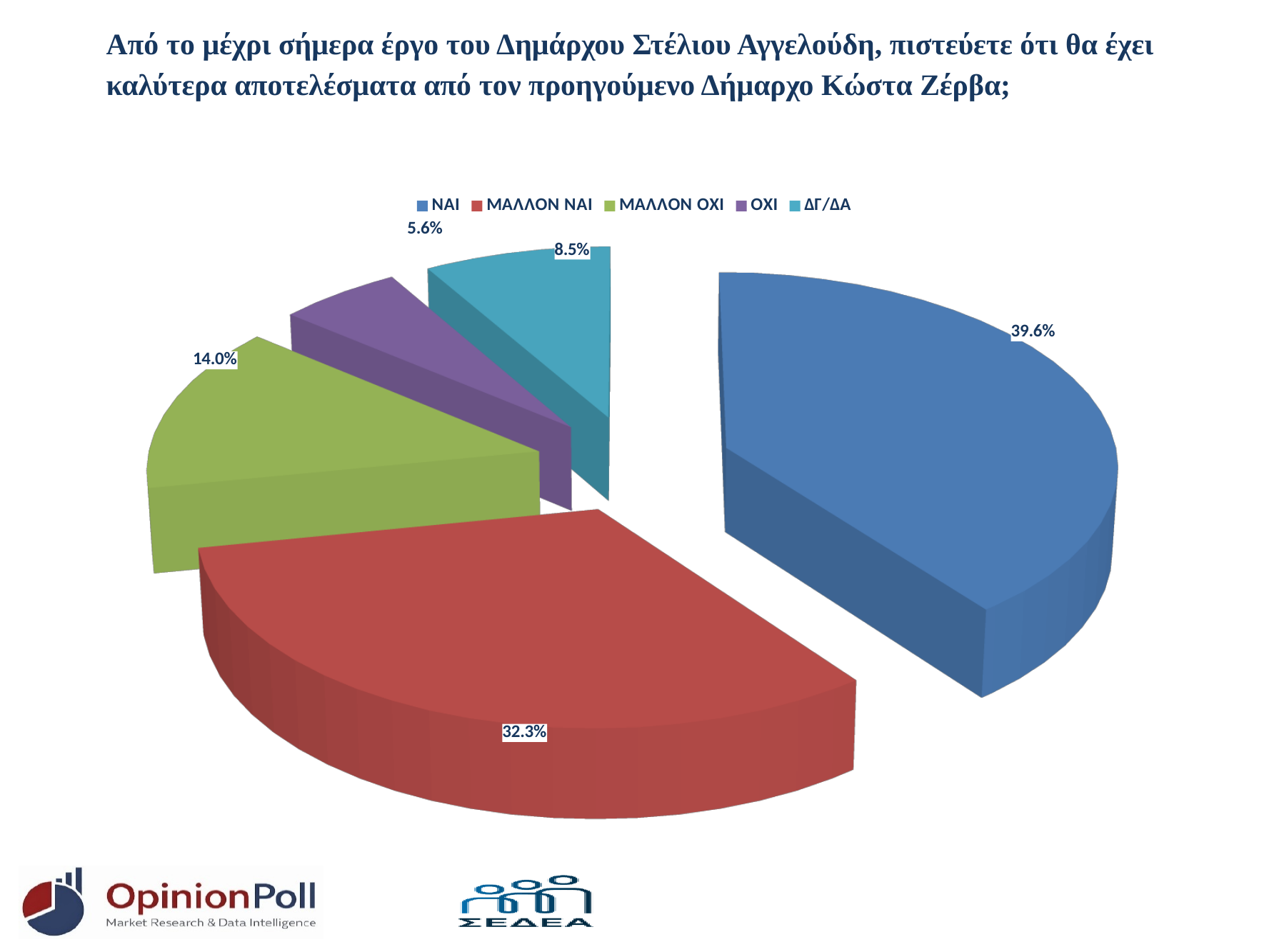
What percentage of respondents answered ΝΑΙ? 39.6% What percentage of respondents answered ΔΓ/ΔΑ? 8.5% Which is larger, the share for ΔΓ/ΔΑ or the share for ΟΧΙ? ΔΓ/ΔΑ How many categories does the legend list? 5 What percentage of respondents answered ΜΑΛΛΟΝ ΝΑΙ? 32.3% What percentage of respondents answered ΟΧΙ? 5.6% Which response category has the smallest share of the pie? ΟΧΙ What type of chart is shown on the slide? Pie chart What percentage of respondents answered ΜΑΛΛΟΝ ΟΧΙ? 14.0% What colour is the slice for ΜΑΛΛΟΝ ΟΧΙ? Green What is the difference in percentage points between ΝΑΙ and ΜΑΛΛΟΝ ΝΑΙ? 7.3 Which response category has the largest share of the pie? ΝΑΙ